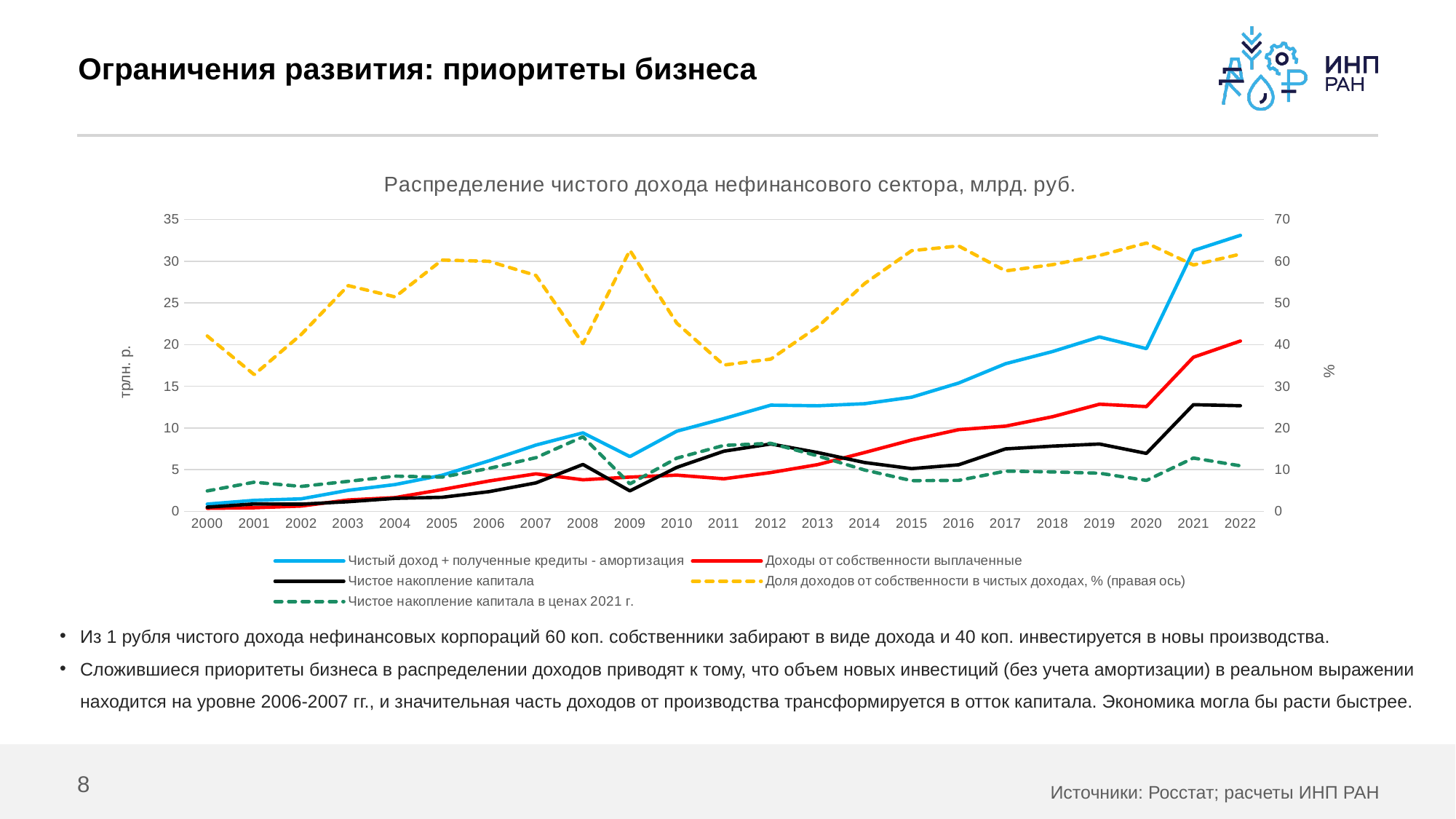
Is the value for 'Доля доходов от собственности в чистых доходах' in 2011 greater or less than 40 on the right axis? less Does 'Чистый доход + полученные кредиты - амортизация' generally rise or fall from 2000 to 2022? rise In 2012, which is larger: 'Чистое накопление капитала' or 'Доходы от собственности выплаченные'? Чистое накопление капитала Is the value for 'Чистый доход + полученные кредиты - амортизация' in 2009 greater or less than 10? less What is the title of the chart? Распределение чистого дохода нефинансового сектора, млрд. руб. What kind of chart is shown on the slide? line chart How many series does the legend list? 5 Which series is plotted on the right axis? Доля доходов от собственности в чистых доходах, % (правая ось) How many years are shown along the x axis? 23 Is the value for 'Чистое накопление капитала' in 2022 greater or less than 10? greater In which year is 'Чистый доход + полученные кредиты - амортизация' at its highest? 2022